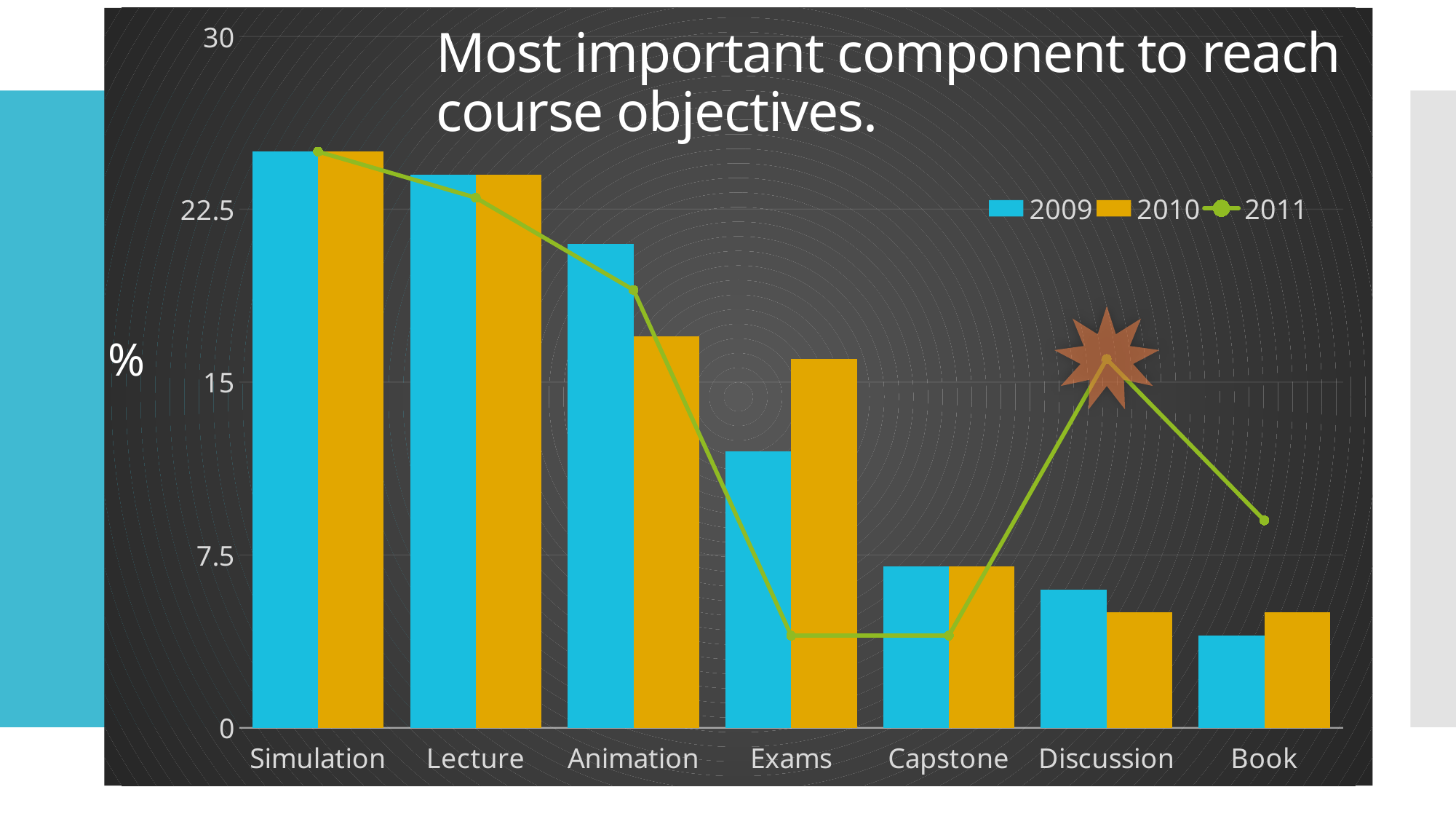
Is the 2011 value for Discussion greater or less than 15? greater For Exams, which series has the larger value, 2009 or 2010? 2010 Which category has the highest value for the 2009 series? Simulation Is the 2010 value for Exams greater or less than 15? greater How many categories are shown on the x axis of the chart? 7 For Animation, which series has the larger value, 2009 or 2010? 2009 Is the 2009 value for Exams greater or less than 15? less Do the 2009 values rise or fall from Simulation to Book along the x axis? fall Which series is plotted as a line rather than bars? 2011 What kind of chart is shown on the slide? bar chart with a line How many series does the chart's legend list? 3 Which category has the lowest value for the 2009 series? Book